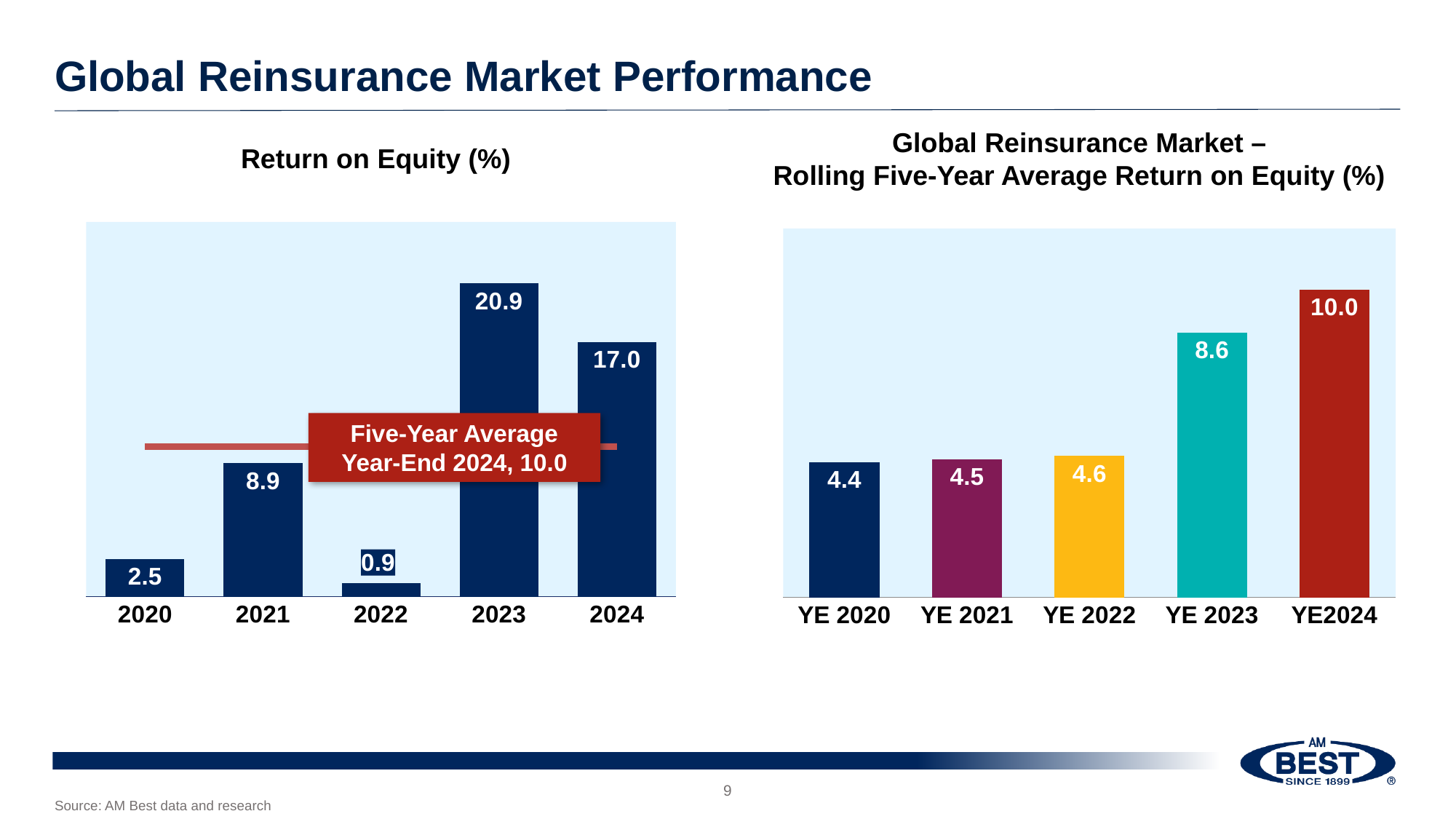
What kind of chart is the Rolling Five-Year Average Return on Equity (%) chart? bar chart In the Rolling Five-Year Average Return on Equity (%) chart, what is the value for YE 2022? 4.6 In the Return on Equity (%) chart, what is the value for 2023? 20.9 In the Return on Equity (%) chart, which is larger, the value for 2021 or the value for 2020? 2021 In the Return on Equity (%) chart, which year has the lowest value? 2022 In the Return on Equity (%) chart, how many years are plotted? 5 In the Rolling Five-Year Average Return on Equity (%) chart, do the values rise or fall from YE 2020 to YE2024? rise In the Rolling Five-Year Average Return on Equity (%) chart, what is the difference between the YE2024 and YE 2023 values? 1.4 In the Rolling Five-Year Average Return on Equity (%) chart, which year-end has the highest value? YE2024 In the Return on Equity (%) chart, what five-year average value does the red line label show? 10.0 In the Rolling Five-Year Average Return on Equity (%) chart, what colour is the YE 2022 bar? yellow In the Return on Equity (%) chart, what is the difference between the 2023 and 2024 values? 3.9